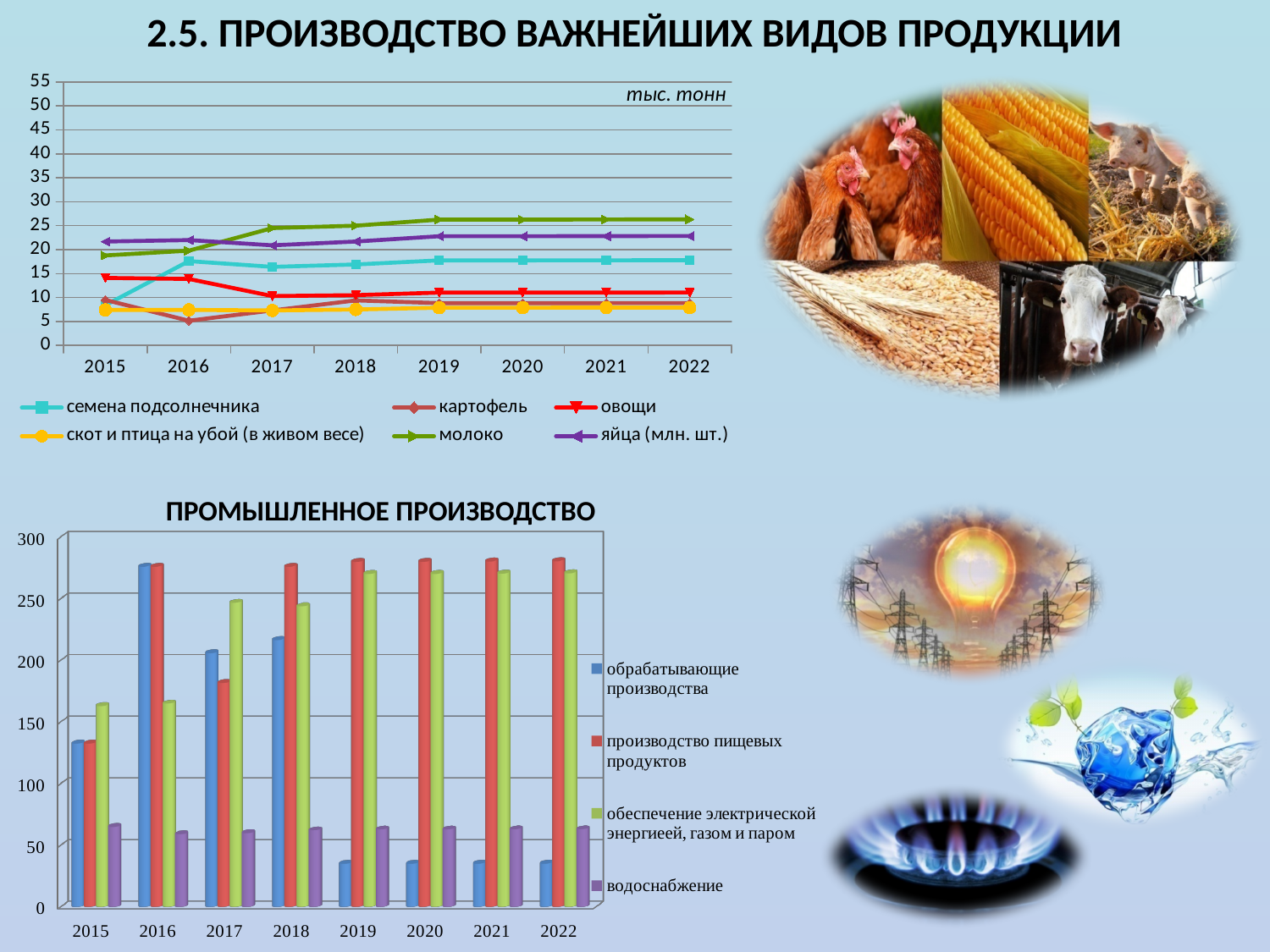
How many series does the legend of the top line chart list? 6 In the top line chart, is the value for 'семена подсолнечника' in 2022 greater or less than 20? less What kind of chart is the top chart on the slide (the one with the unit 'тыс. тонн')? line chart What kind of chart is the 'ПРОМЫШЛЕННОЕ ПРОИЗВОДСТВО' chart? bar chart How many series does the legend of the 'ПРОМЫШЛЕННОЕ ПРОИЗВОДСТВО' chart list? 4 In the 'ПРОМЫШЛЕННОЕ ПРОИЗВОДСТВО' chart, is the value for 'обрабатывающие производства' larger in 2016 or in 2022? 2016 How many years are shown on the x axis of the 'ПРОМЫШЛЕННОЕ ПРОИЗВОДСТВО' chart? 8 In the top line chart, does the value for 'молоко' rise or fall from 2015 to 2022? rise In the top line chart, which series has the highest value in 2022? молоко In the top line chart, is the value for 'молоко' in 2022 greater or less than 20? greater In the 'ПРОМЫШЛЕННОЕ ПРОИЗВОДСТВО' chart, which series has the lowest value in 2022? обрабатывающие производства In the 'ПРОМЫШЛЕННОЕ ПРОИЗВОДСТВО' chart, is the value for 'производство пищевых продуктов' in 2022 greater or less than 250? greater